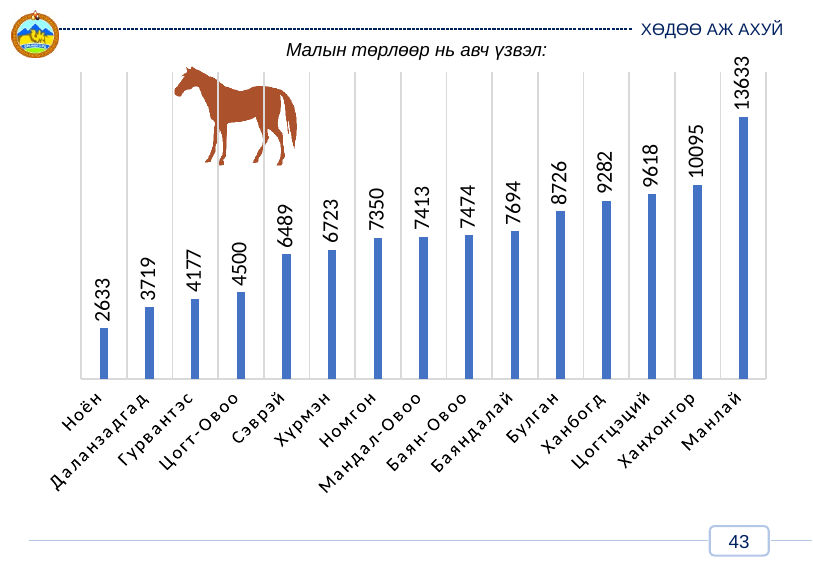
Do the values rise or fall from left to right across the categories? Rise What is the value shown for Даланзадгад? 3719 Which category has the highest value? Манлай How many categories are shown on the chart? 15 What is the difference between the values for Манлай and Ханхонгор? 3538 Which has a larger value, Булган or Сэврэй? Булган Which has a larger value, Гурвантэс or Цогтцэций? Цогтцэций What is the difference between the values for Цогт-Овоо and Ноён? 1867 What is the value shown for Ханбогд? 9282 What kind of chart is shown on the slide? Bar chart What is the value shown for Манлай? 13633 Which category has the lowest value? Ноён